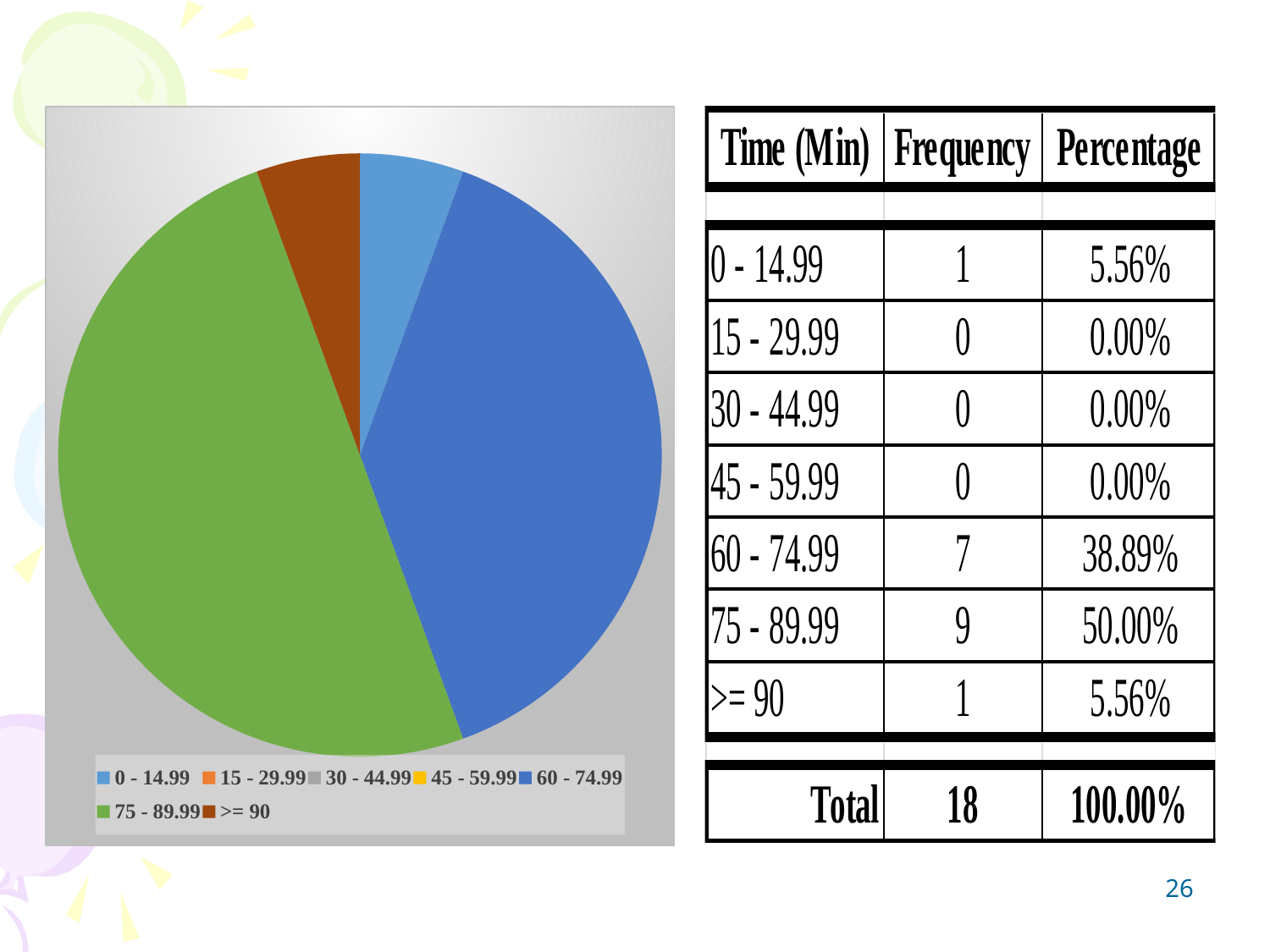
Which time category has the largest slice of the pie chart? 75 - 89.99 What kind of chart is shown on the slide? pie chart What colour is the slice for the 75 - 89.99 category in the pie chart? green What percentage share does the 60 - 74.99 category have, according to the table? 38.89% How many time categories have a frequency of 0? 3 What is the frequency for the 0 - 14.99 time category? 1 Which is larger, the slice for 60 - 74.99 or the slice for >= 90? 60 - 74.99 What is the difference in frequency between the 75 - 89.99 and 60 - 74.99 categories? 2 How many categories does the pie chart's legend list? 7 What is the frequency for the 60 - 74.99 time category? 7 What percentage share does the 75 - 89.99 category have, according to the table? 50.00% What is the total frequency shown in the table? 18